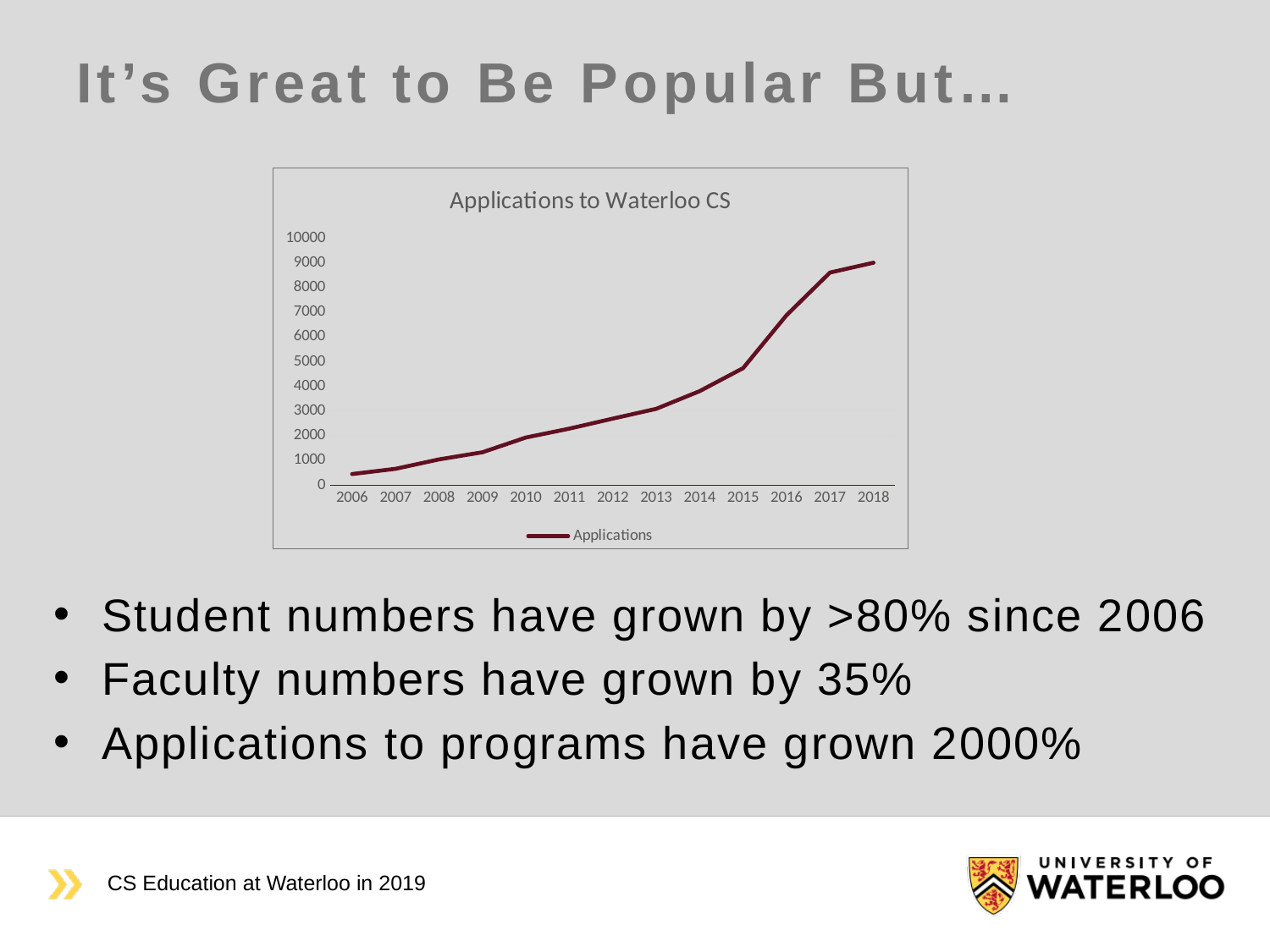
Which year has the highest number of applications? 2018 What is the title of the chart? Applications to Waterloo CS Is the value for 2018 greater or less than 8000? greater Is the value for 2015 greater or less than 4000? greater How many years are plotted along the x axis? 13 Is the value for 2006 greater or less than 1000? less What is the name of the series shown in the legend? Applications Which year has more applications, 2010 or 2017? 2017 Which year has the lowest number of applications? 2006 Do applications rise or fall from 2006 to 2018? rise What kind of chart is shown on the slide? line chart How many series does the chart's legend list? 1